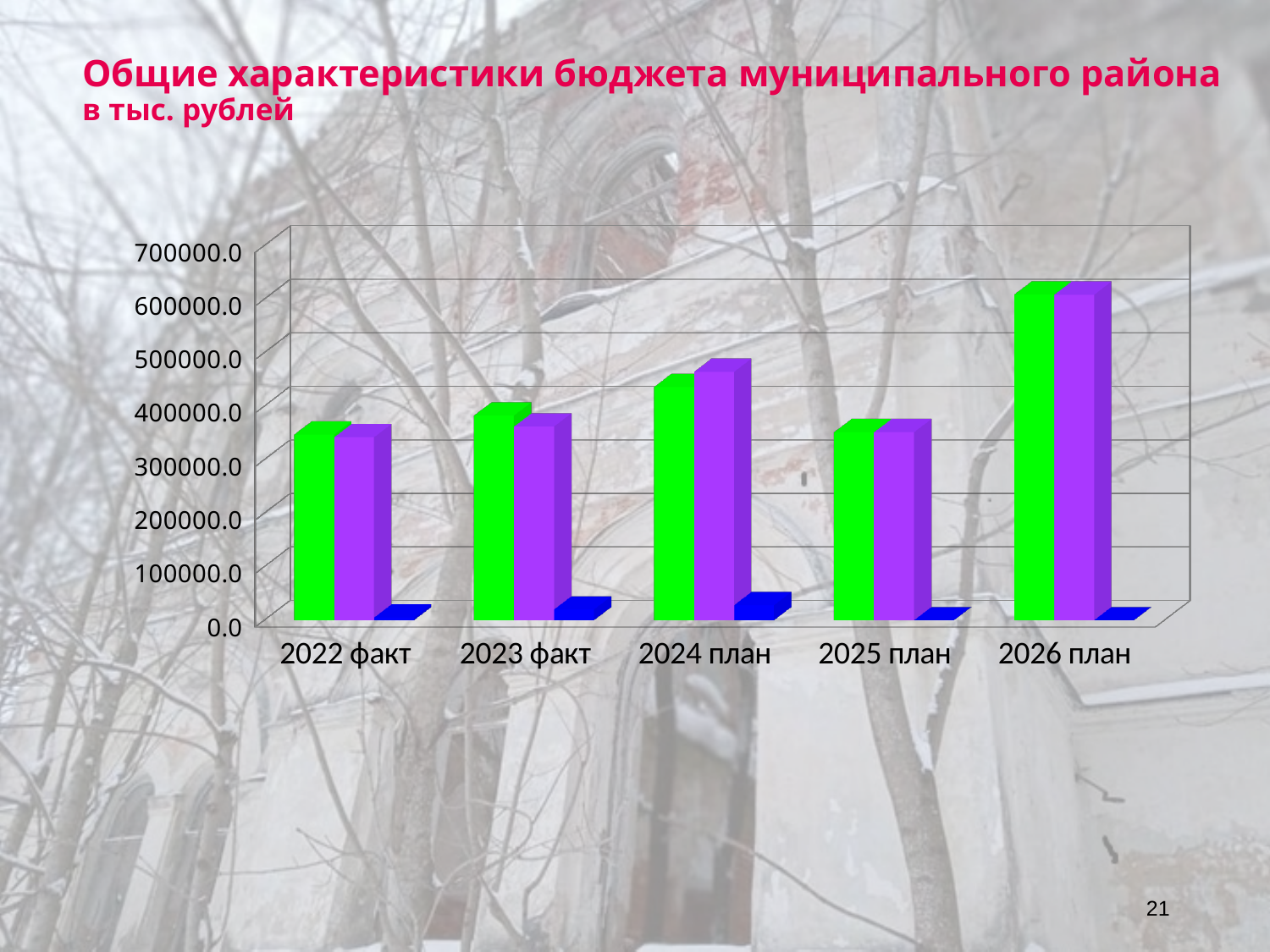
Which category has the tallest purple bar? 2026 план What is the highest tick value shown on the y axis? 700000.0 Is the blue bar for 2024 план greater or less than 100000.0? less What is the title of the chart on the slide? Общие характеристики бюджета муниципального района Which category has the tallest green bar? 2026 план Which category has the tallest blue bar? 2024 план How many categories are shown on the x axis of the chart? 5 Is the green bar for 2024 план greater or less than 400000.0? greater For 2024 план, which bar is taller, the green one or the purple one? the purple one Is the green bar for 2025 план greater or less than 400000.0? less What kind of chart is shown on the slide? bar chart